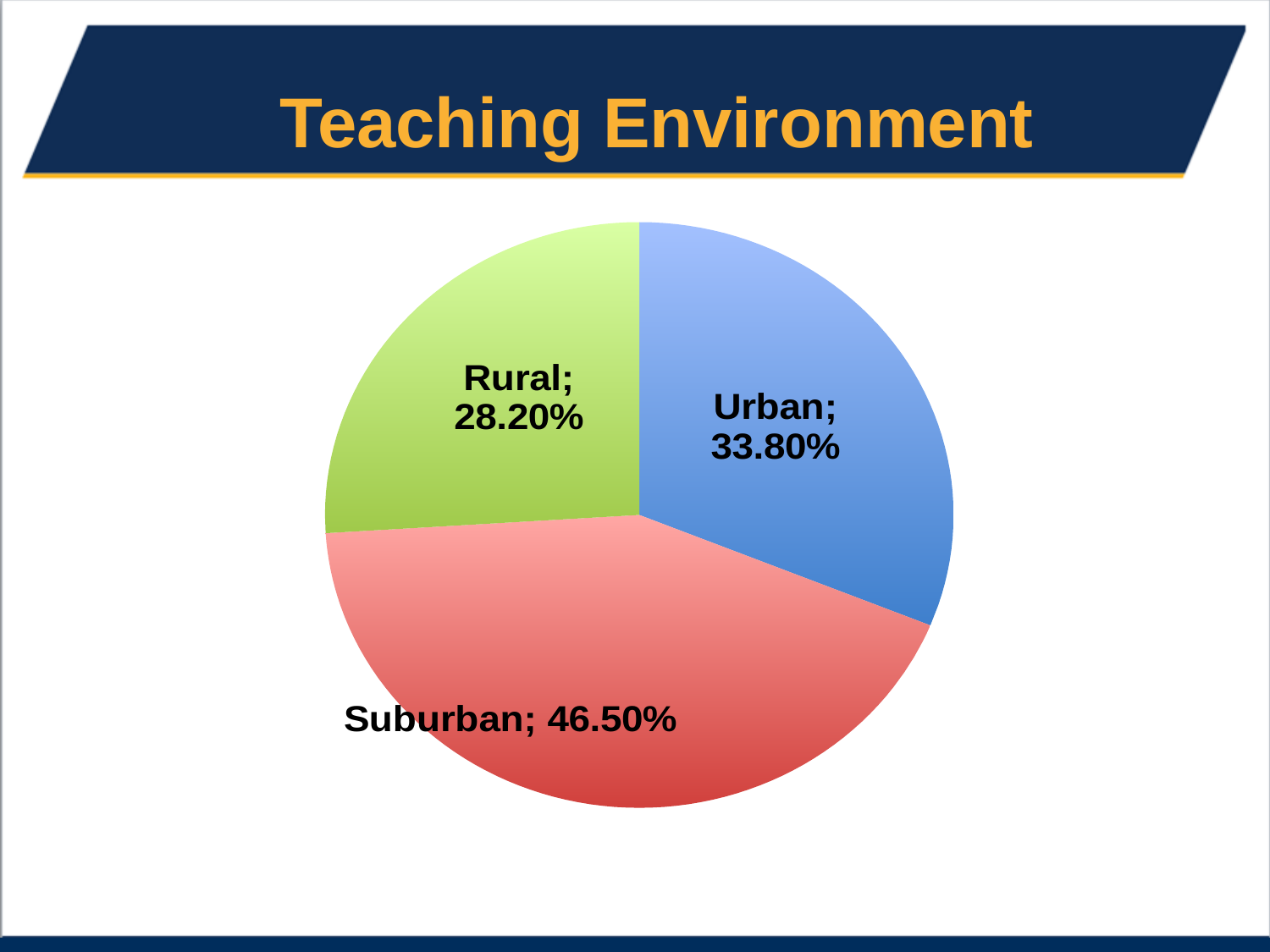
What kind of chart is shown on the slide? Pie chart Which is larger, the Urban share or the Rural share? Urban What is the difference in percentage points between Urban and Rural? 5.60 What colour is the Suburban slice? Red What is the difference in percentage points between Suburban and Urban? 12.70 What percentage of the pie is Suburban? 46.50% What percentage of the pie is Urban? 33.80% What is the title of the slide containing the chart? Teaching Environment What percentage of the pie is Rural? 28.20% How many categories are shown in the pie chart? 3 Which category has the largest share of the pie? Suburban Which category has the smallest share of the pie? Rural